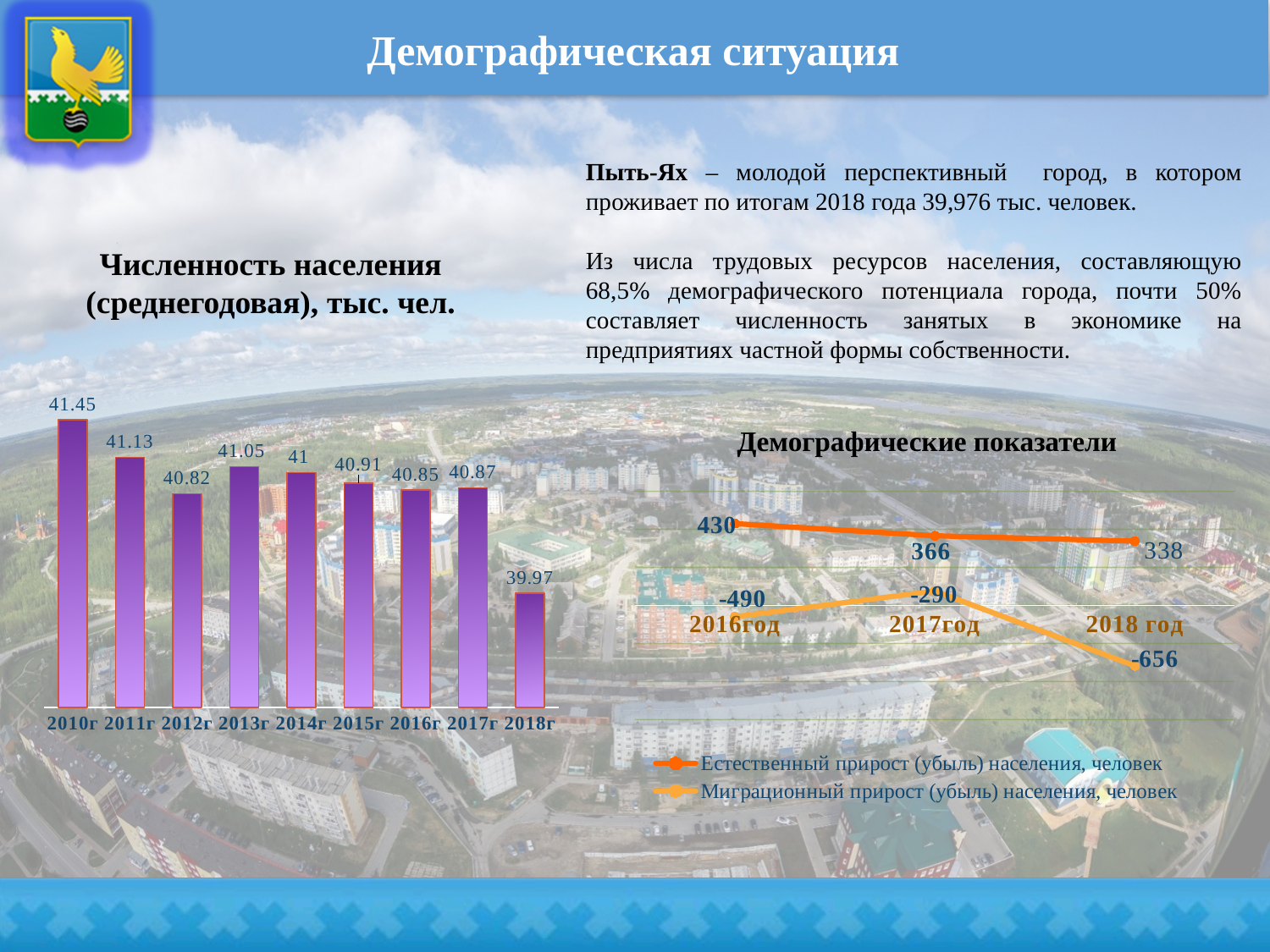
In the chart 'Численность населения (среднегодовая), тыс. чел.', how many years are shown? 9 In the chart 'Демографические показатели', how many series does the legend list? 2 In the chart 'Демографические показатели', what is the value of 'Естественный прирост (убыль) населения, человек' for 2017год? 366 In the chart 'Численность населения (среднегодовая), тыс. чел.', what is the value for 2010г? 41.45 What type of chart is 'Численность населения (среднегодовая), тыс. чел.'? bar chart In the chart 'Численность населения (среднегодовая), тыс. чел.', which year has the lowest value? 2018г In the chart 'Демографические показатели', what is the difference between the 'Естественный прирост' value for 2016год and the value for 2018 год? 92 In the chart 'Демографические показатели', does the series 'Естественный прирост (убыль) населения, человек' rise or fall from 2016год to 2018 год? fall In the chart 'Численность населения (среднегодовая), тыс. чел.', which year has the highest value? 2010г In the chart 'Демографические показатели', what is the value of 'Миграционный прирост (убыль) населения, человек' for 2018 год? -656 In the chart 'Численность населения (среднегодовая), тыс. чел.', what is the value for 2018г? 39.97 In the chart 'Численность населения (среднегодовая), тыс. чел.', what is the difference between the values for 2010г and 2018г? 1.48